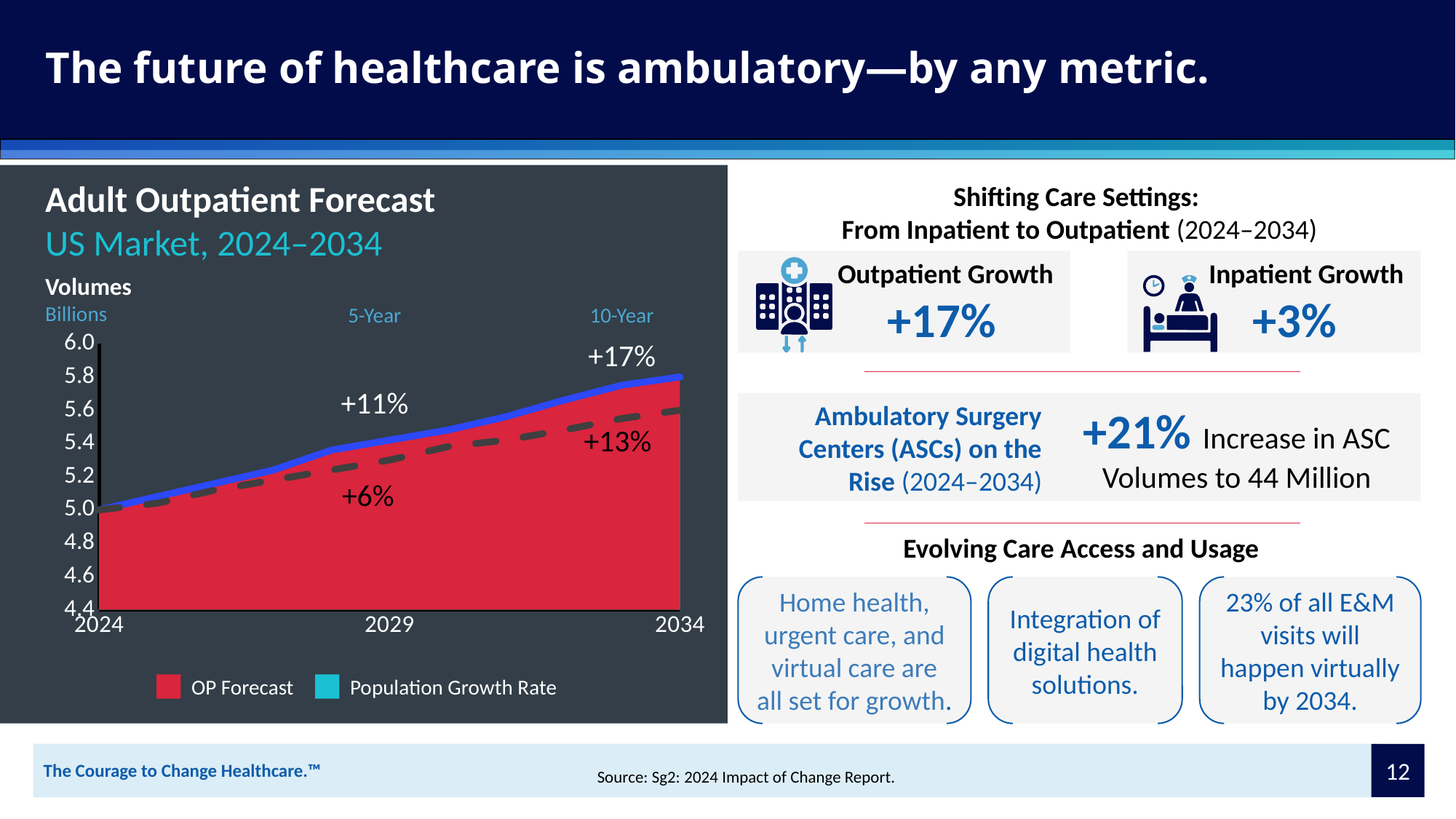
By how many percentage points does the 10-Year OP Forecast growth (+17%) exceed the 10-Year Population Growth Rate (+13%)? 4 percentage points What kind of chart is the Adult Outpatient Forecast chart? Area and line chart What is the 5-Year growth label shown for the Population Growth Rate series? +6% Does the OP Forecast rise or fall from 2024 to 2034? Rises Is the OP Forecast value in 2034 greater or less than 5.6 billion? greater Which series shows the larger 10-Year growth, OP Forecast or Population Growth Rate? OP Forecast How many year labels are shown on the x axis of the chart? 3 What is the 5-Year growth label shown for the OP Forecast series? +11% How many series does the chart legend list? 2 What is the title of the chart on the left of the slide? Adult Outpatient Forecast What is the 10-Year growth label shown for the Population Growth Rate series? +13% What is the 10-Year growth label shown for the OP Forecast series? +17%